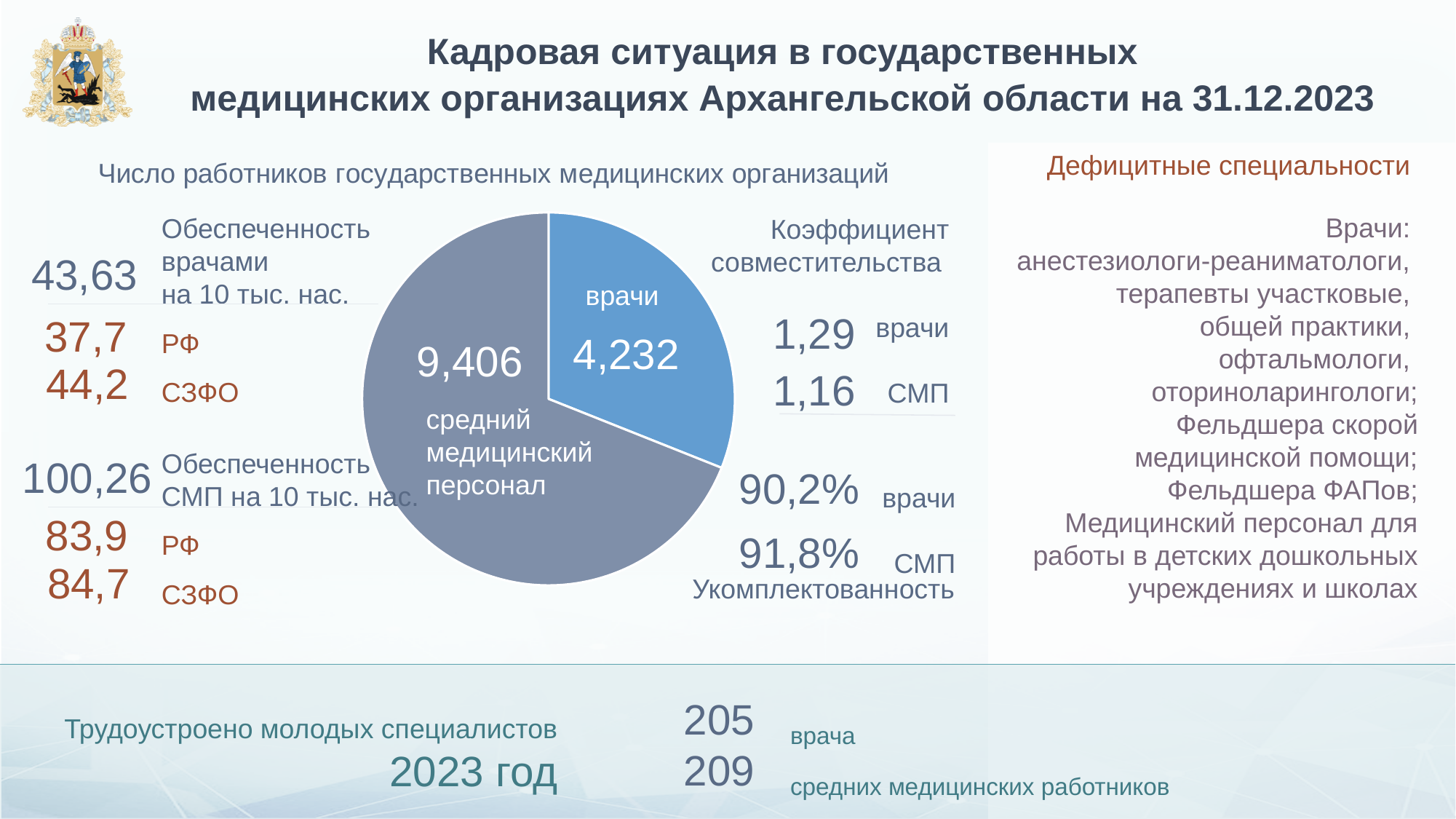
What colour is the врачи slice in the pie chart? blue What value is shown for the средний медицинский персонал slice of the pie chart? 9,406 What value is shown for the врачи slice of the pie chart? 4,232 Does the врачи slice make up more or less than half of the pie chart? less What is the total of the two slices in the pie chart? 13,638 What is the difference between the средний медицинский персонал value and the врачи value in the pie chart? 5,174 How many slices does the pie chart have? 2 Which slice of the pie chart is the smallest? врачи What is the title of the pie chart? Число работников государственных медицинских организаций Which is larger in the pie chart: врачи or средний медицинский персонал? средний медицинский персонал Which slice of the pie chart is the largest? средний медицинский персонал What type of chart is shown on the slide? pie chart